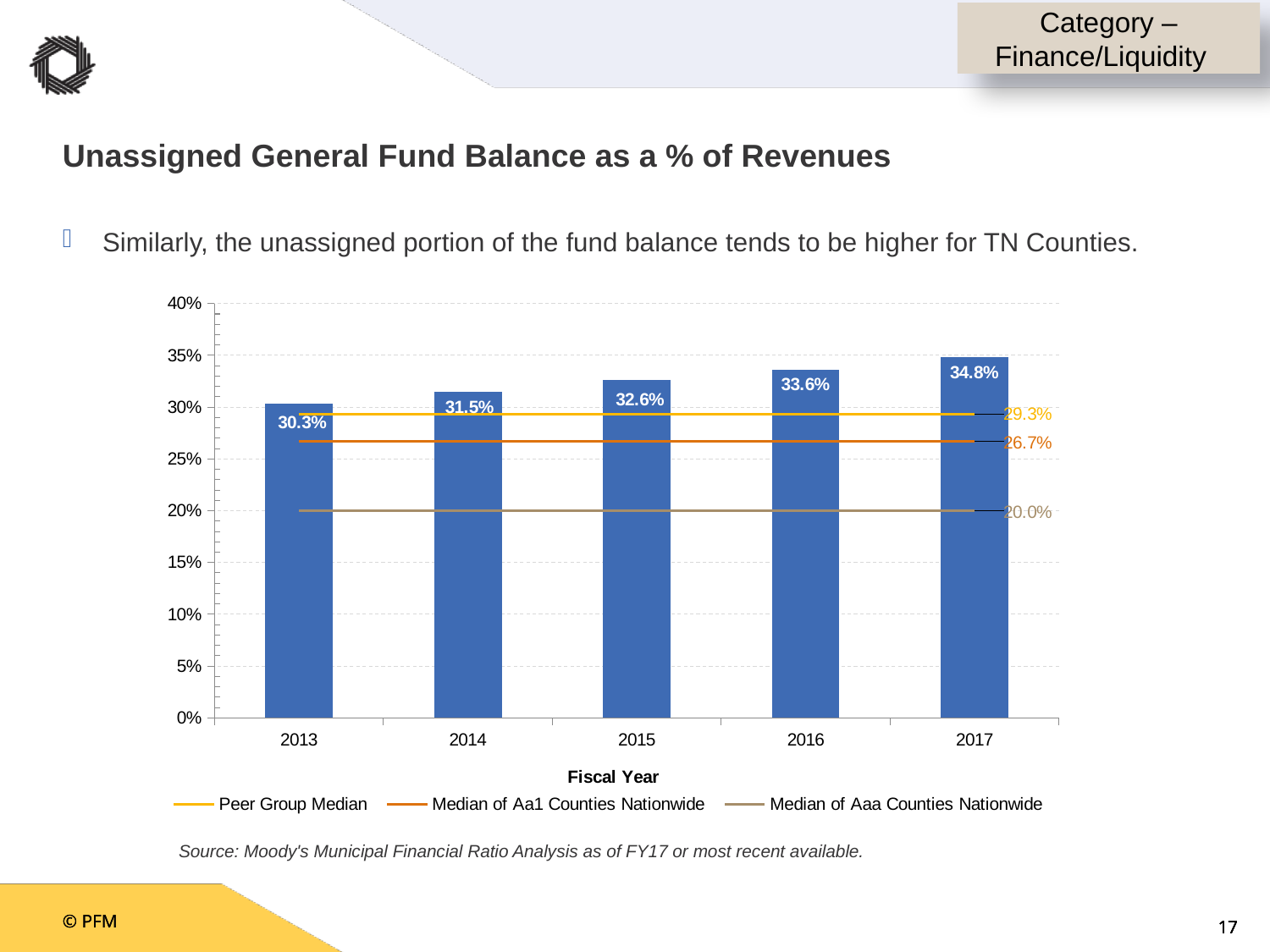
What is the difference between the Peer Group Median and the Median of Aa1 Counties Nationwide? 2.6% Which fiscal year has the highest bar? 2017 What is the unassigned general fund balance as a % of revenues for fiscal year 2013? 30.3% Which is larger, the 2015 bar value or the Median of Aa1 Counties Nationwide? 2015 bar value What is the value of the bar for fiscal year 2017? 34.8% What is the difference between the 2017 bar value and the 2013 bar value? 4.5% How many fiscal years are shown on the x axis? 5 What value is shown for the Peer Group Median line? 29.3% Do the bar values rise or fall from 2013 to 2017? rise How many series does the legend list? 3 Which fiscal year has the lowest bar? 2013 What value is shown for the Median of Aaa Counties Nationwide line? 20.0%